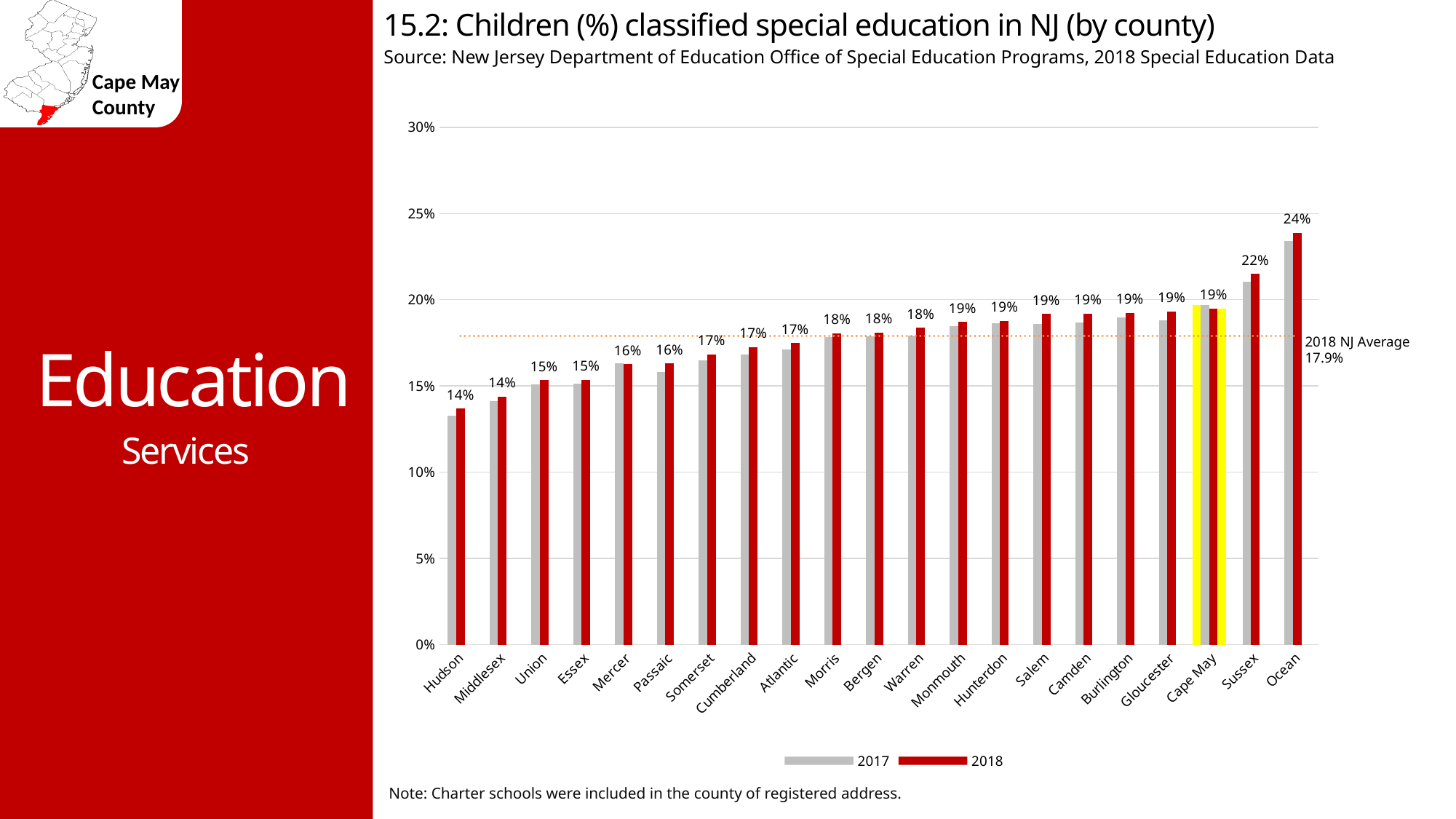
What is the labelled value for Ocean county? 24% What is the labelled value for Cape May county? 19% What kind of chart is shown on the slide? bar chart How many series does the chart legend list? 2 What is the 2018 NJ Average shown by the dotted line on the chart? 17.9% How many counties are shown along the x axis of the chart? 21 Which county has a larger labelled value, Sussex or Mercer? Sussex Is the 2017 value for Ocean county greater or less than 20%? greater Which county has the highest percentage of children classified special education? Ocean Which county has the lowest percentage of children classified special education? Hudson What is the labelled value for Mercer county? 16% What is the difference between the labelled values for Ocean and Hudson? 10 percentage points